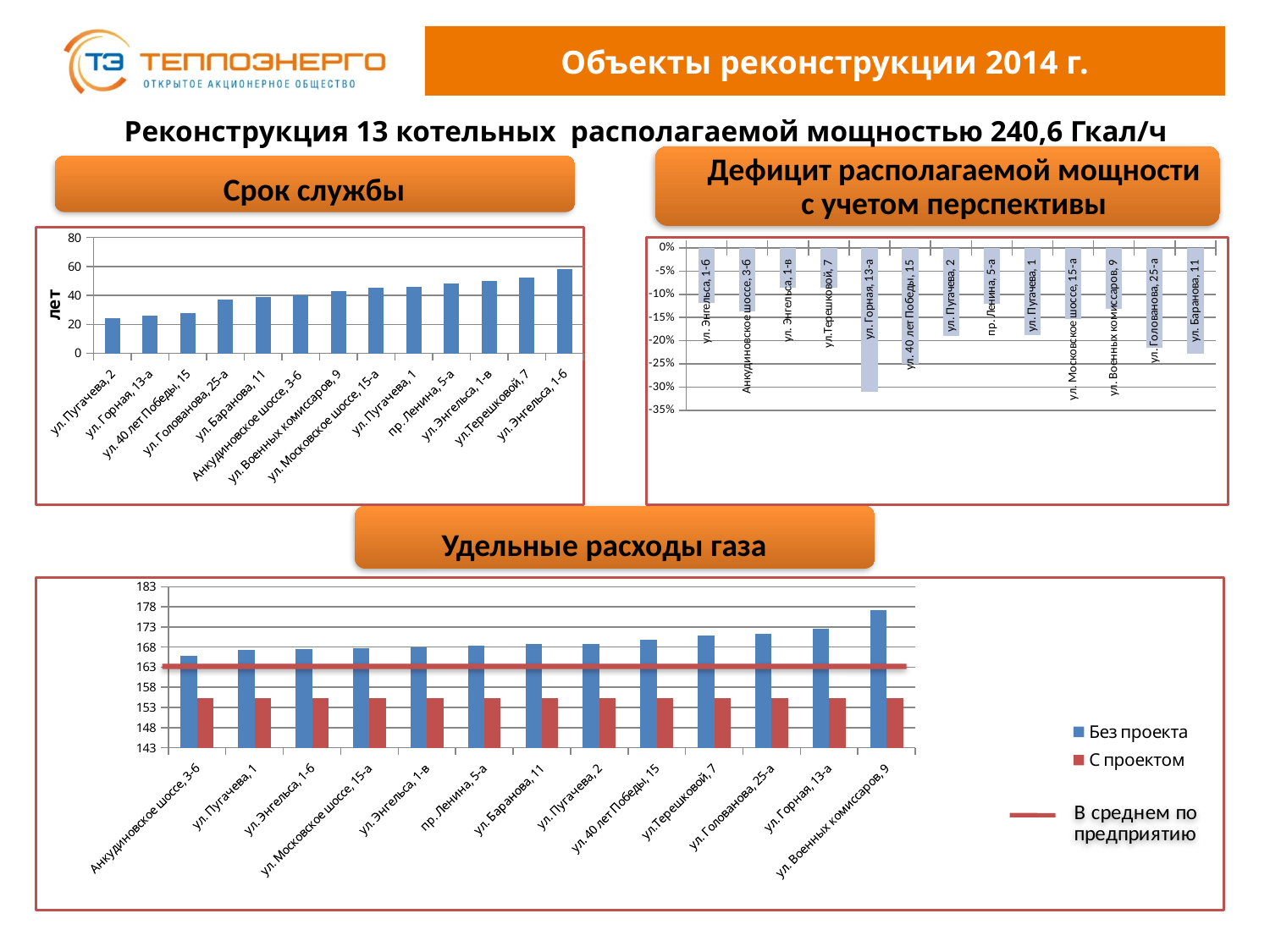
In the 'Удельные расходы газа' chart, is the 'Без проекта' value for ул. Военных комиссаров, 9 greater or less than 173? greater What kind of chart is the 'Срок службы' chart? bar chart In the 'Дефицит располагаемой мощности с учетом перспективы' chart, which boiler house has the largest deficit (the lowest value)? ул. Горная, 13-а In the 'Срок службы' chart, do the values rise or fall from left to right along the x axis? rise In the 'Срок службы' chart, how many boiler houses (categories) are shown? 13 In the 'Срок службы' chart, which boiler house has the lowest value? ул. Пугачева, 2 In the 'Удельные расходы газа' chart, which boiler house has the highest 'Без проекта' value? ул. Военных комиссаров, 9 In the 'Срок службы' chart, which boiler house has the highest value? ул. Энгельса, 1-б In the 'Дефицит располагаемой мощности с учетом перспективы' chart, how many boiler houses are shown? 13 In the 'Удельные расходы газа' chart, how many series does the legend list? 3 In the 'Срок службы' chart, is the value for ул. Пугачева, 2 greater or less than 40? less In the 'Срок службы' chart, is the value for ул. Терешковой, 7 greater or less than 40? greater